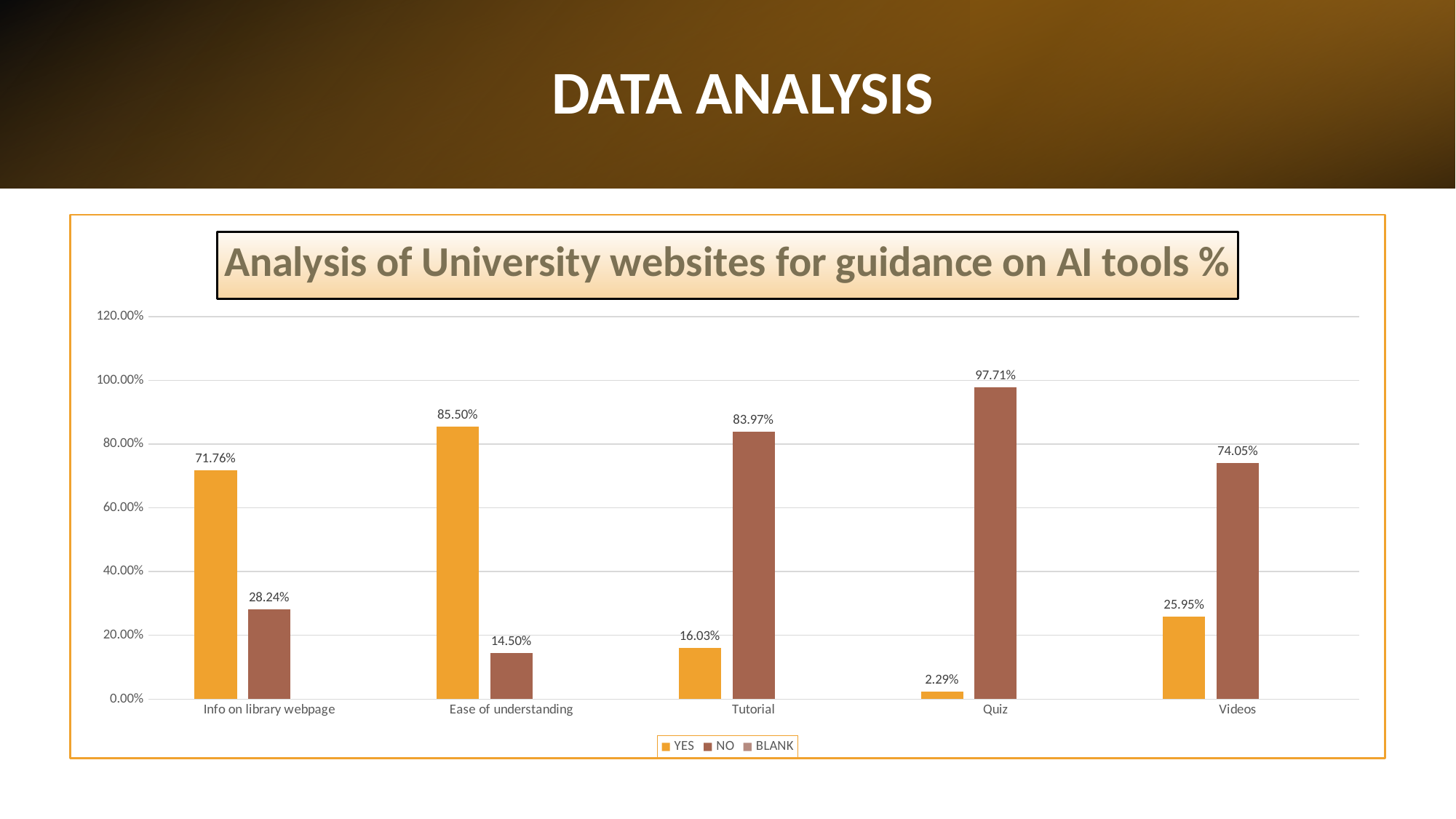
How many series does the legend list? 3 What is the title of the chart? Analysis of University websites for guidance on AI tools % Which is larger for Info on library webpage, the YES value or the NO value? YES Which category has the highest YES value? Ease of understanding Which category has the lowest YES value? Quiz What is the YES value for Ease of understanding? 85.50% What is the NO value for Quiz? 97.71% Which category has the lowest NO value? Ease of understanding What is the YES value for Videos? 25.95% How many categories are shown on the x axis? 5 What is the difference between the YES and NO values for Tutorial? 67.94% What kind of chart is shown on the slide? Bar chart